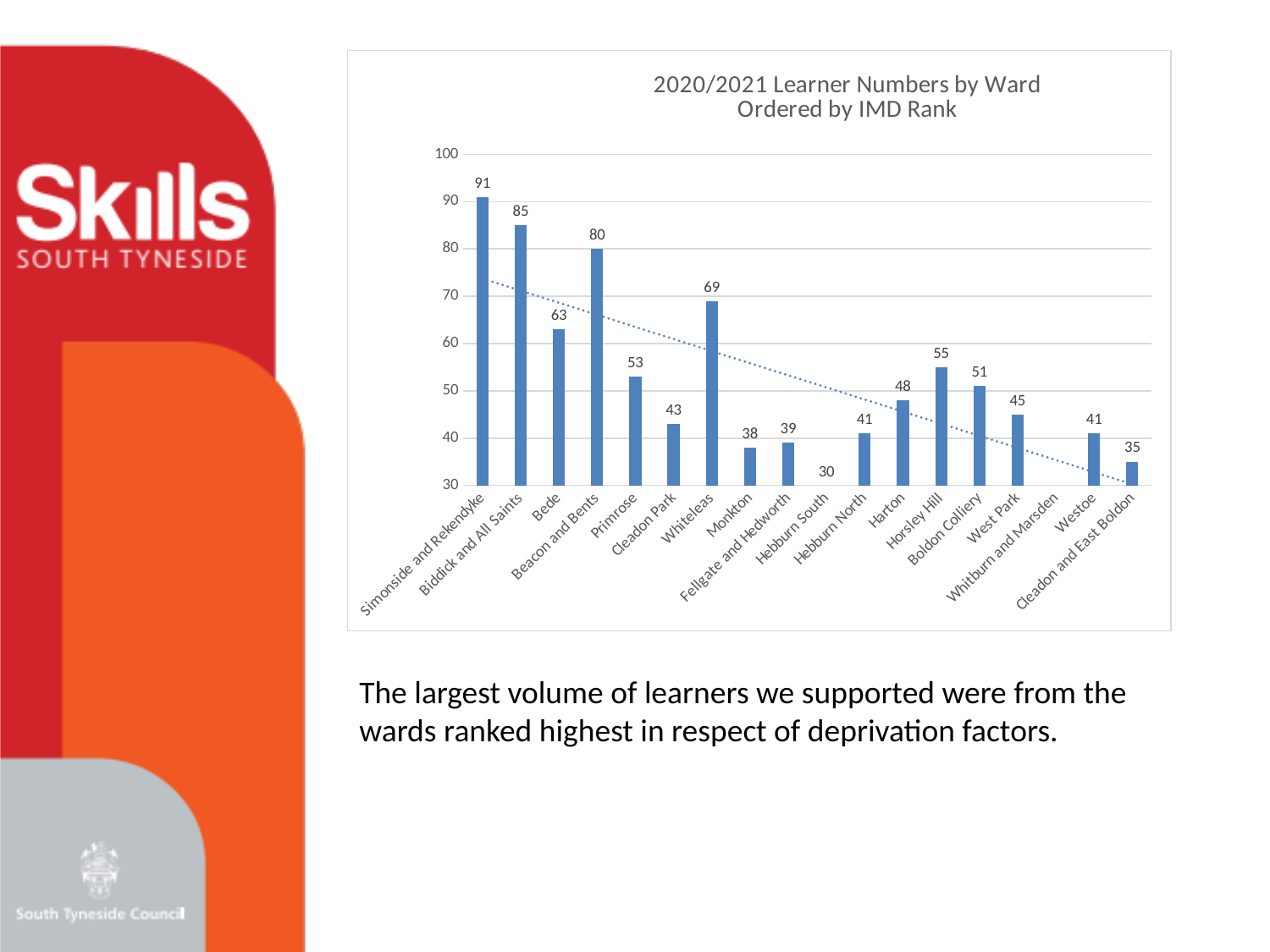
What is the learner number for Cleadon and East Boldon? 35 Which has more learners, Whiteleas or Primrose? Whiteleas What is the learner number for Simonside and Rekendyke? 91 What is the title of the chart? 2020/2021 Learner Numbers by Ward Ordered by IMD Rank What kind of chart is shown on the slide? Bar chart What is the learner number for Whiteleas? 69 Is the value for Harton greater or less than 40? greater Which ward has the highest learner number? Simonside and Rekendyke What is the difference in learner numbers between Beacon and Bents and Bede? 17 What is the learner number for Horsley Hill? 55 What is the difference in learner numbers between Simonside and Rekendyke and Biddick and All Saints? 6 How many wards are shown on the x axis of the chart? 18